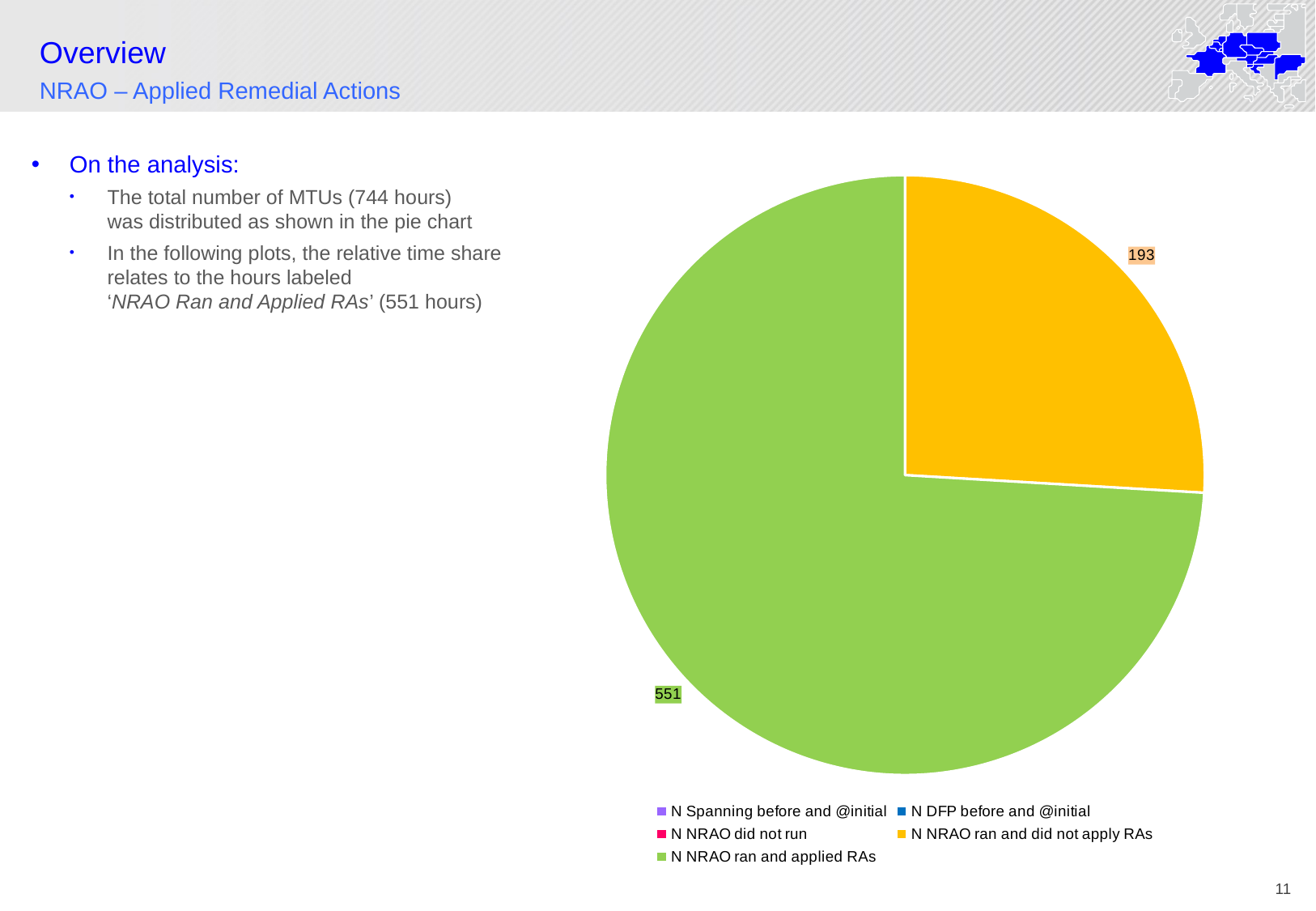
What is the difference between the 'N NRAO ran and applied RAs' value and the 'N NRAO ran and did not apply RAs' value in the pie chart? 358 Does the 'N NRAO ran and applied RAs' slice account for more or less than half of the pie chart? more Which slice of the pie chart is the largest? N NRAO ran and applied RAs How many entries does the legend of the pie chart list? 5 What type of chart is shown on the slide? pie chart Which is larger in the pie chart: 'N NRAO ran and applied RAs' or 'N NRAO ran and did not apply RAs'? N NRAO ran and applied RAs What colour is the 'N NRAO ran and did not apply RAs' slice in the pie chart? yellow What is the total of the two labelled slices in the pie chart? 744 How many slices with data labels are visible in the pie chart? 2 What value is shown for the 'N NRAO ran and applied RAs' slice of the pie chart? 551 What value is shown for the 'N NRAO ran and did not apply RAs' slice of the pie chart? 193 Which of the two labelled slices in the pie chart is the smallest? N NRAO ran and did not apply RAs